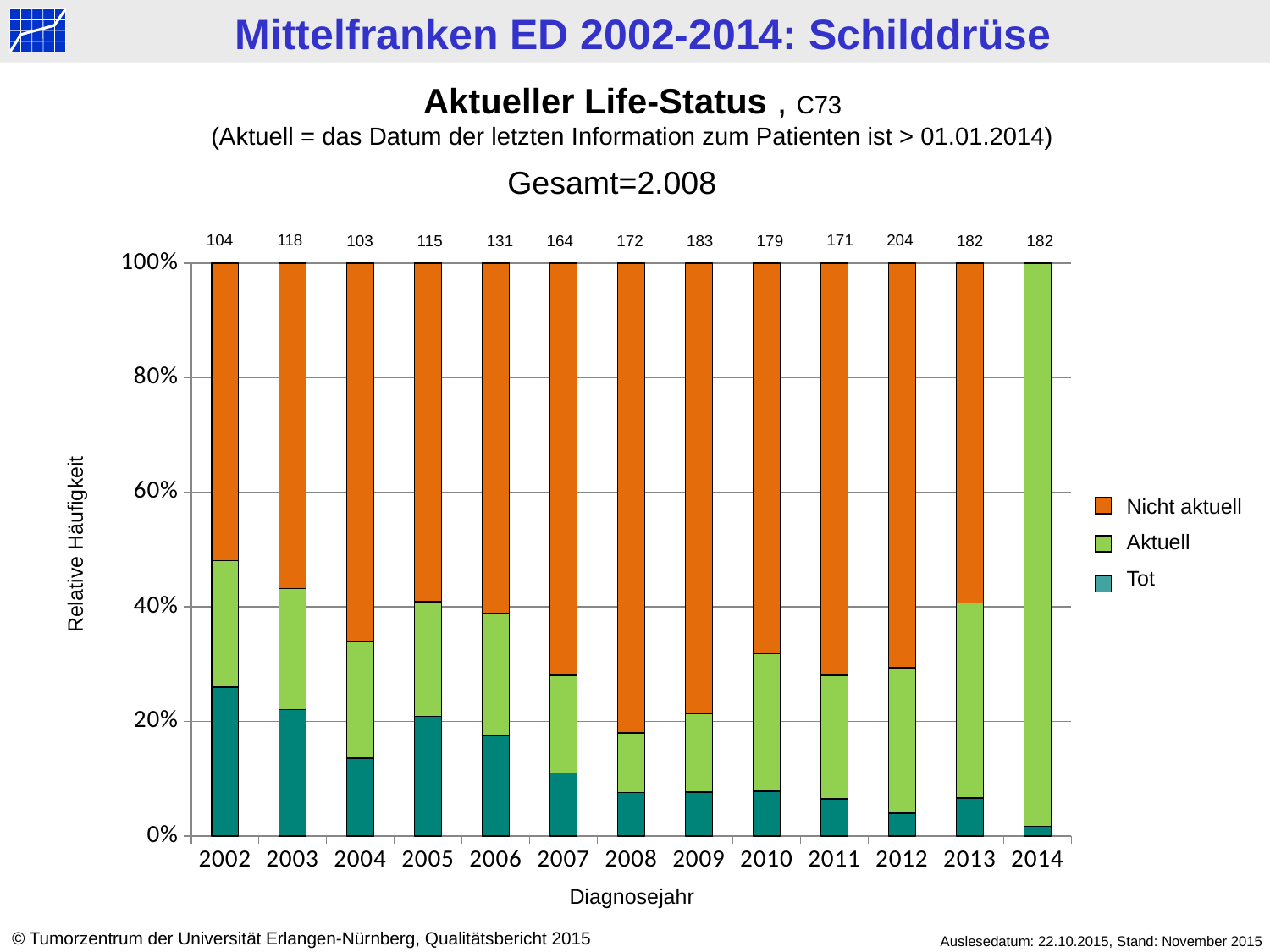
How many series does the legend list? 3 How many Diagnosejahr categories are shown on the x axis? 13 What number is printed above the bar for 2002? 104 What is the difference between the numbers printed above the bars for 2012 and 2002? 100 Which Diagnosejahr has the highest number printed above its bar? 2012 Does the share of Tot generally rise or fall from 2002 to 2014? fall Is the share of Tot in 2014 greater or less than 20%? less What number is printed above the bar for 2012? 204 Is the share of Tot in 2002 greater or less than 20%? greater What kind of chart is shown on the slide? stacked bar chart Which Diagnosejahr has the lowest number printed above its bar? 2004 Which year has the larger number printed above its bar, 2009 or 2010? 2009